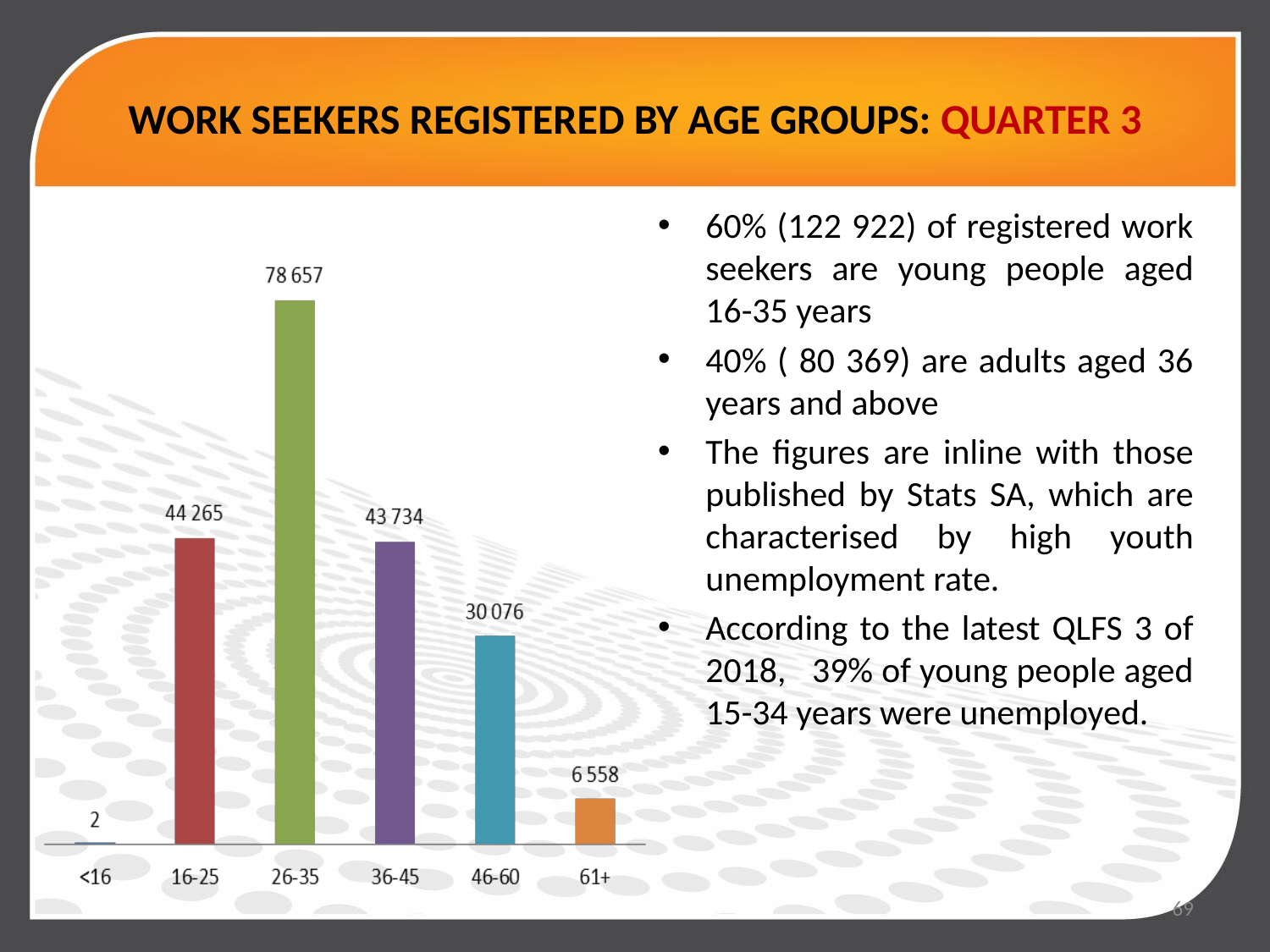
Which age group has the highest number of registered work seekers? 26-35 How many age groups are shown in the chart? 6 What is the difference between the 26-35 and 46-60 age groups? 48 581 What is the number of registered work seekers in the 26-35 age group? 78 657 What is the value shown for the <16 age group? 2 What type of chart is shown on the slide? Bar chart What is the number of registered work seekers in the 61+ age group? 6 558 What colour is the bar for the 26-35 age group? Green What is the number of registered work seekers in the 46-60 age group? 30 076 What is the difference between the 16-25 and 36-45 age groups? 531 Which age group has the lowest number of registered work seekers? <16 Which has more registered work seekers, the 16-25 group or the 46-60 group? 16-25